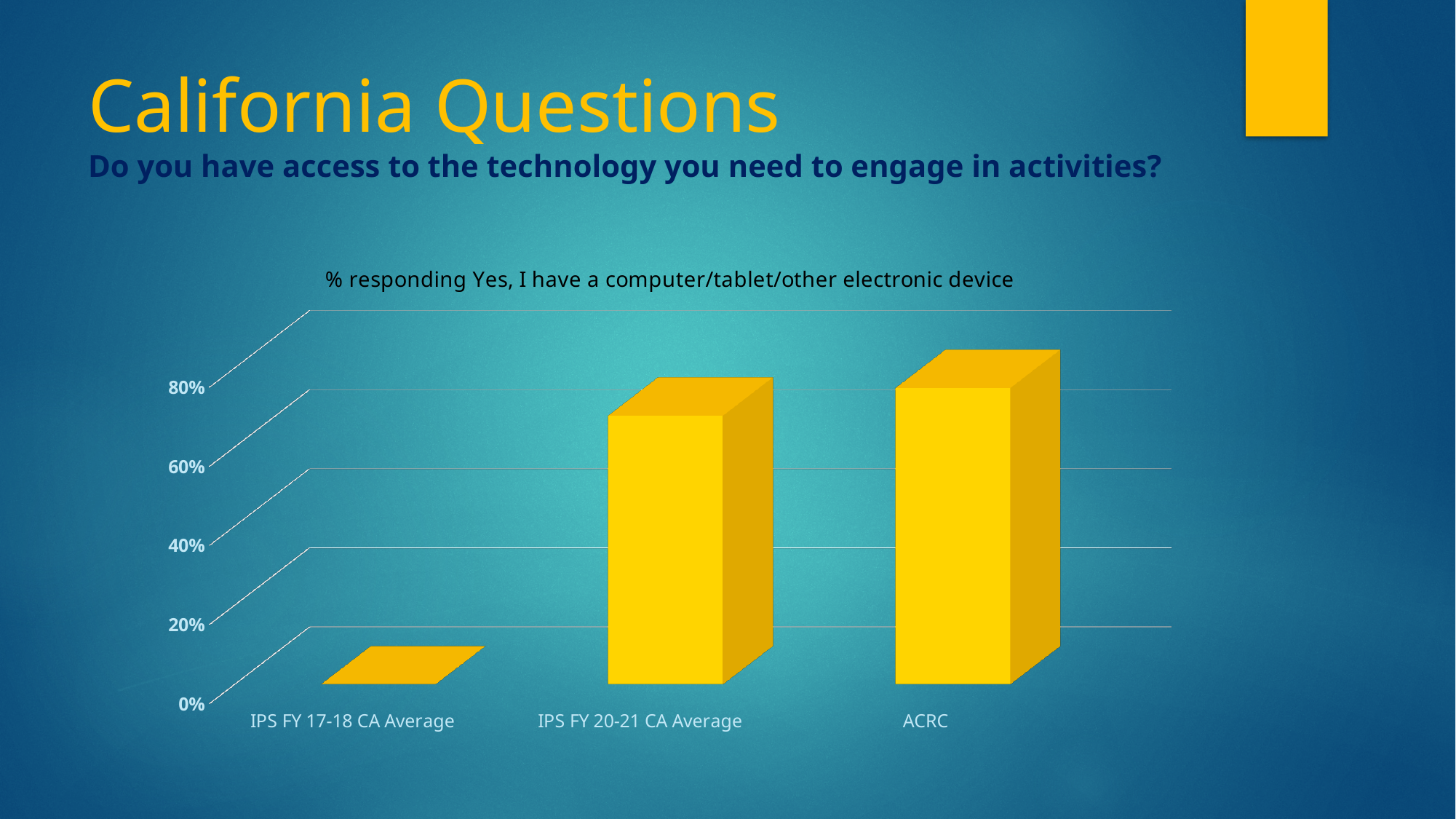
Is the value for ACRC greater or less than 60%? greater Do the values rise or fall moving left to right across the categories? rise Which is larger, the value for ACRC or the value for IPS FY 20-21 CA Average? ACRC What kind of chart is shown on the slide? bar chart Is the value for IPS FY 20-21 CA Average greater or less than 40%? greater Which category has the lowest value? IPS FY 17-18 CA Average What colour are the bars in the chart? yellow Is the value for IPS FY 17-18 CA Average greater or less than 20%? less How many categories are plotted in the chart? 3 What is the title of the chart? % responding Yes, I have a computer/tablet/other electronic device Which category has the highest value? ACRC